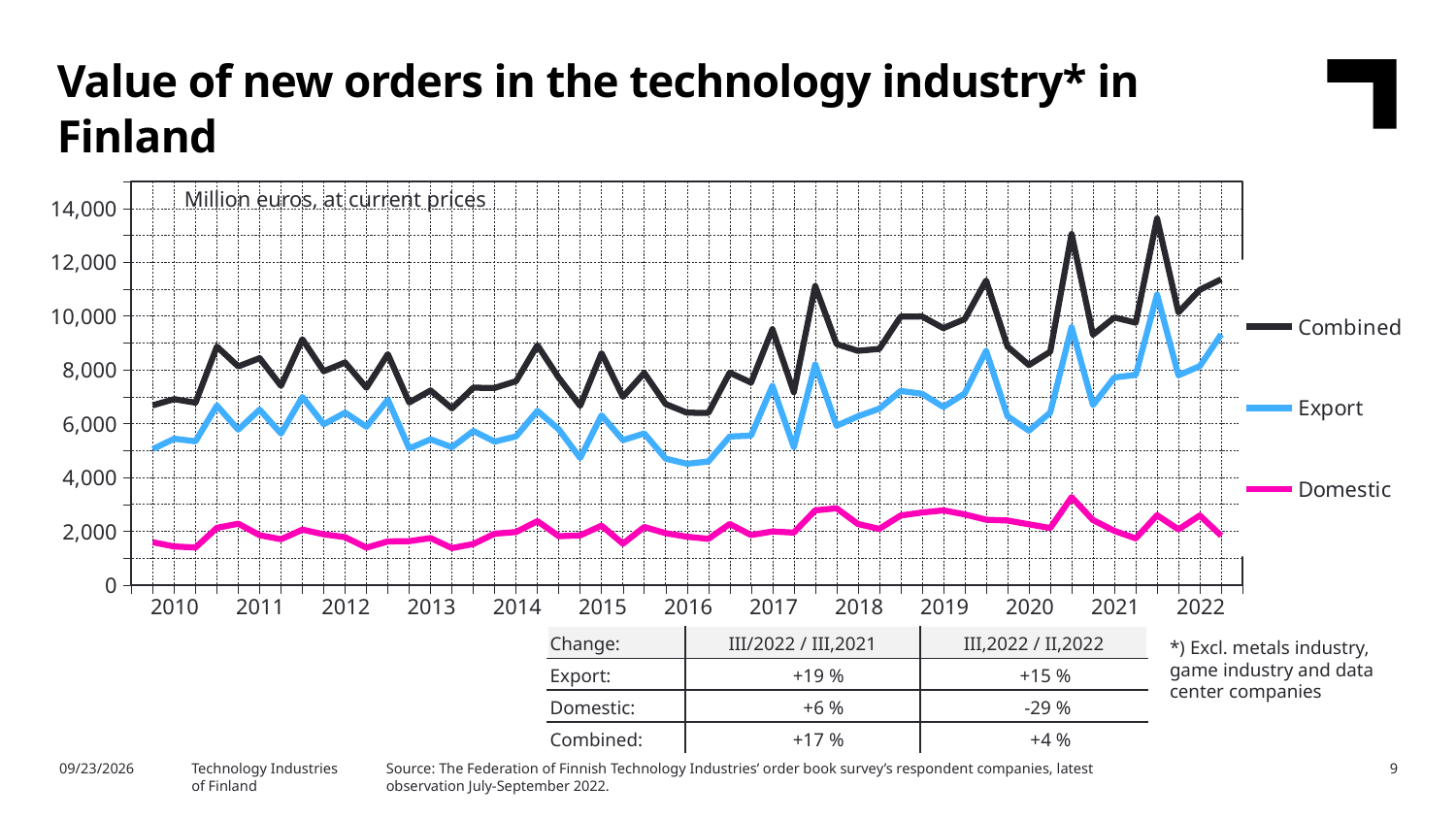
How many series does the chart's legend list? 3 Does the Combined series overall rise or fall from 2016 to 2022? rise Which series has the highest values throughout the chart? Combined Which series is larger in 2022, Export or Domestic? Export What unit is stated for the values in the chart? Million euros, at current prices Is the peak value of the Combined series in 2021 greater or less than 12,000? greater Is the lowest value of the Export series in 2016 greater or less than 6,000? less Which series are listed in the chart's legend? Combined, Export, Domestic Which series has the lowest values throughout the chart? Domestic How many years are labelled on the x axis of the chart? 13 Is the value for the Domestic series ever greater or less than 4,000 across the chart? less What kind of chart is shown on the slide? Line chart